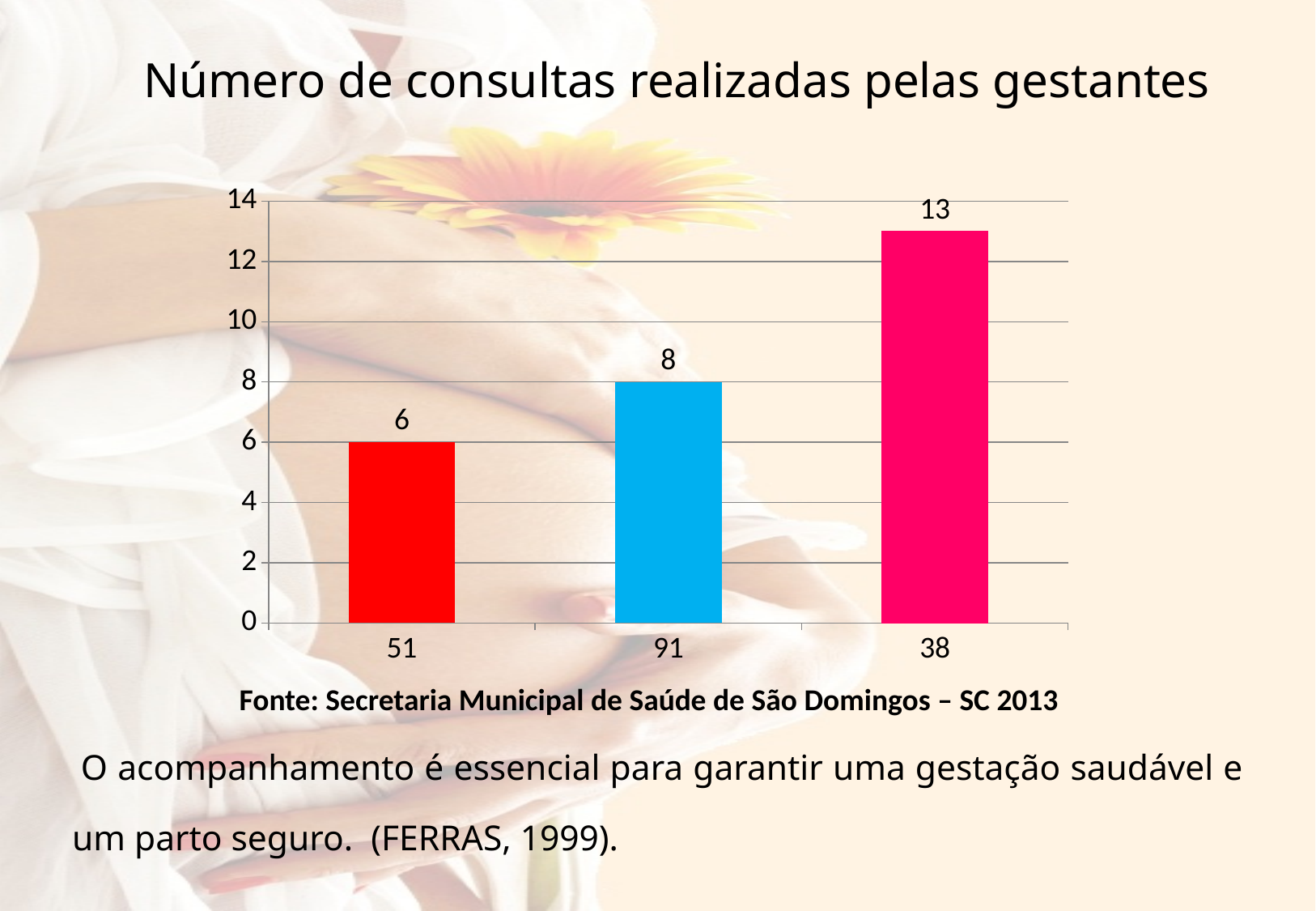
Which category has the lowest value? 51 What is the value for category 38? 13 What is the value for category 91? 8 Is the value for 38 greater or less than 12? greater What is the difference between the values for 91 and 51? 2 Which category has the highest value? 38 What is the title of the chart? Número de consultas realizadas pelas gestantes Which is larger, the value for 91 or the value for 38? 38 What is the difference between the values for 38 and 51? 7 How many categories are shown on the x axis? 3 What kind of chart is shown on the slide? bar chart What is the value for category 51? 6